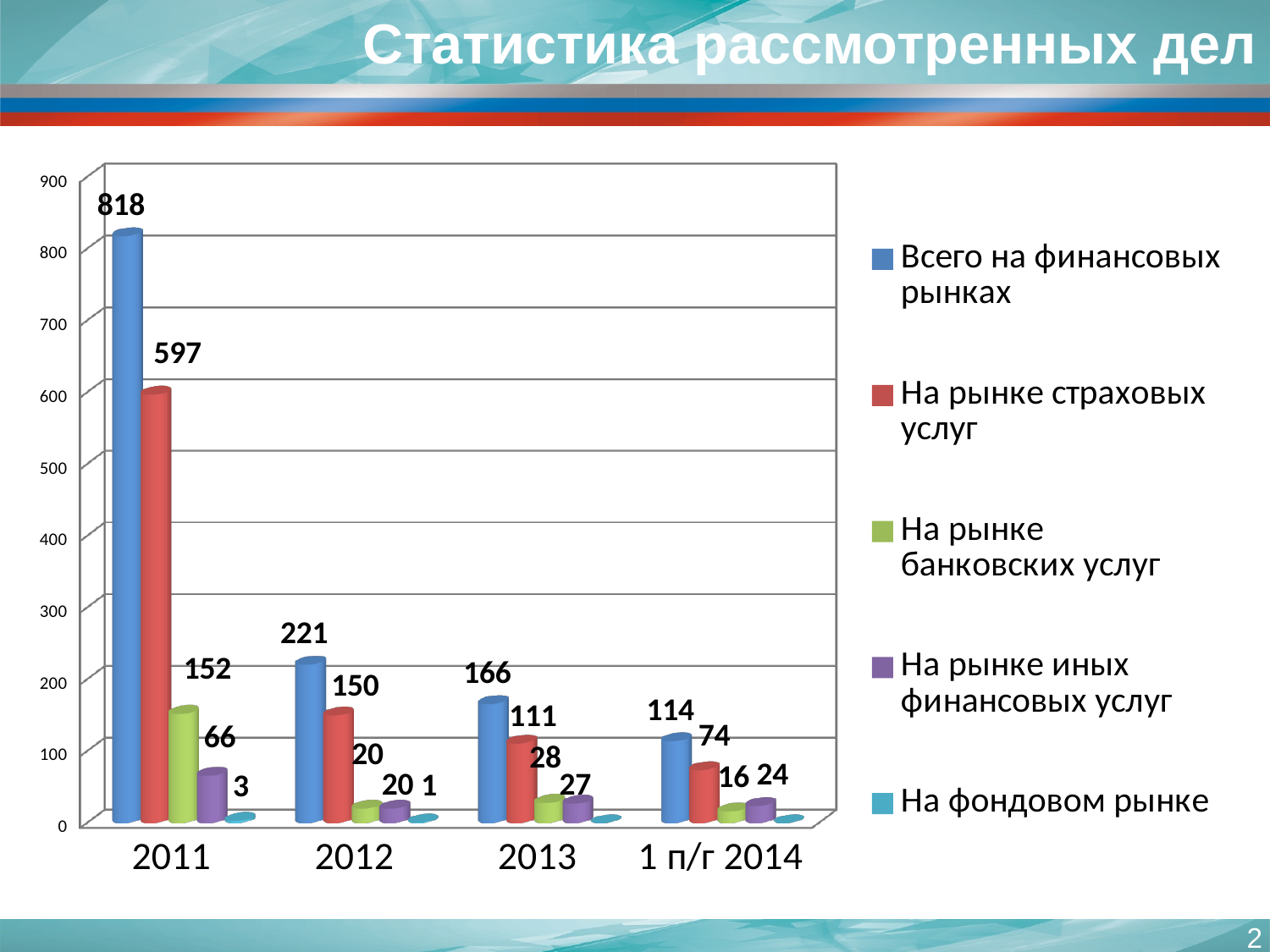
What is the value for "На рынке страховых услуг" in 2012? 150 In which category is the value for "На рынке страховых услуг" lowest? 1 п/г 2014 In which year is the value for "Всего на финансовых рынках" highest? 2011 What kind of chart is shown on the slide? Bar chart How many series does the legend list? 5 How many categories are shown on the x axis? 4 Which is larger in 2013: "На рынке банковских услуг" or "На рынке иных финансовых услуг"? На рынке банковских услуг What is the value for "На рынке иных финансовых услуг" in 1 п/г 2014? 24 Does the value for "Всего на финансовых рынках" rise or fall from 2011 to 1 п/г 2014? Fall What is the difference between "Всего на финансовых рынках" and "На рынке страховых услуг" in 2011? 221 What is the value for "Всего на финансовых рынках" in 2011? 818 What is the value for "На рынке банковских услуг" in 2013? 28